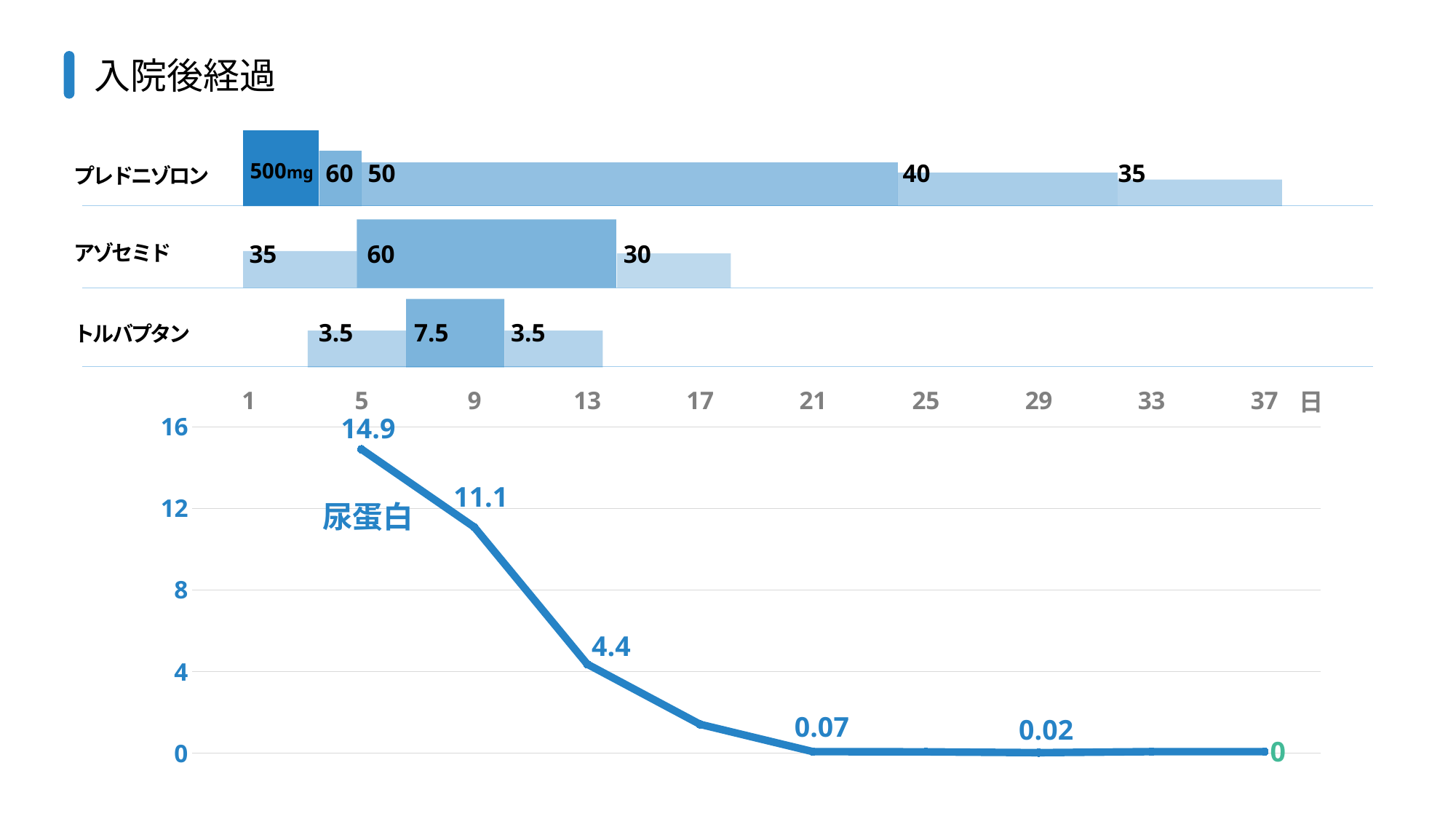
In the upper medication chart, what is the highest dose shown for トルバプタン? 7.5 In the lower line chart, which is larger: the value labeled 11.1 or the value labeled 4.4? 11.1 In the lower line chart, is the unlabeled point near day 17 greater or less than 4? less In the lower line chart, what is the highest labeled 尿蛋白 value? 14.9 In the upper medication chart, what is the middle dose shown for アゾセミド? 60 In the lower line chart, do the 尿蛋白 values rise or fall as the days increase? fall In the lower line chart, what is the difference between the first two labeled values, 14.9 and 11.1? 3.8 In the lower line chart, what is the last labeled value of 尿蛋白 at the right end of the line? 0 What kind of chart is the lower chart showing 尿蛋白? line chart In the upper medication chart, how many medications are listed? 3 In the lower line chart, what is the first labeled value of 尿蛋白? 14.9 In the upper medication chart, what is the first dose shown for プレドニゾロン? 500mg